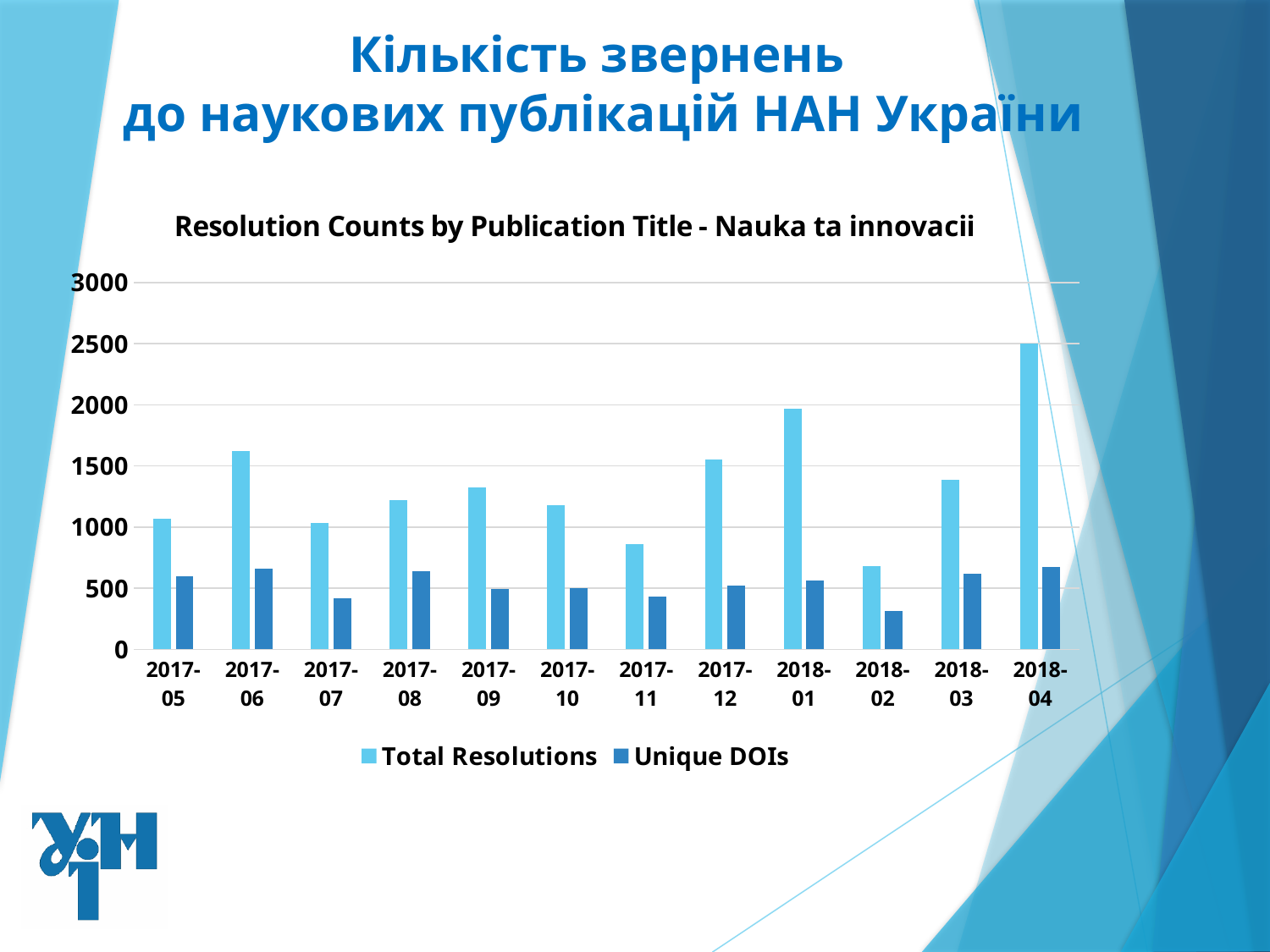
Which month has the larger Total Resolutions, 2017-06 or 2017-07? 2017-06 Do Total Resolutions rise or fall from 2018-02 to 2018-04? rise Is the Total Resolutions value for 2018-01 greater or less than 1500? greater Which month has the highest Total Resolutions? 2018-04 What kind of chart is shown on the slide? bar chart How many series does the legend list? 2 Is the Total Resolutions value for 2017-11 greater or less than 1000? less Which month has the lowest Total Resolutions? 2018-02 Is the Unique DOIs value for 2017-07 greater or less than 500? less Which month has the lowest Unique DOIs? 2018-02 What is the title of the chart? Resolution Counts by Publication Title - Nauka ta innovacii How many months are shown on the x axis? 12